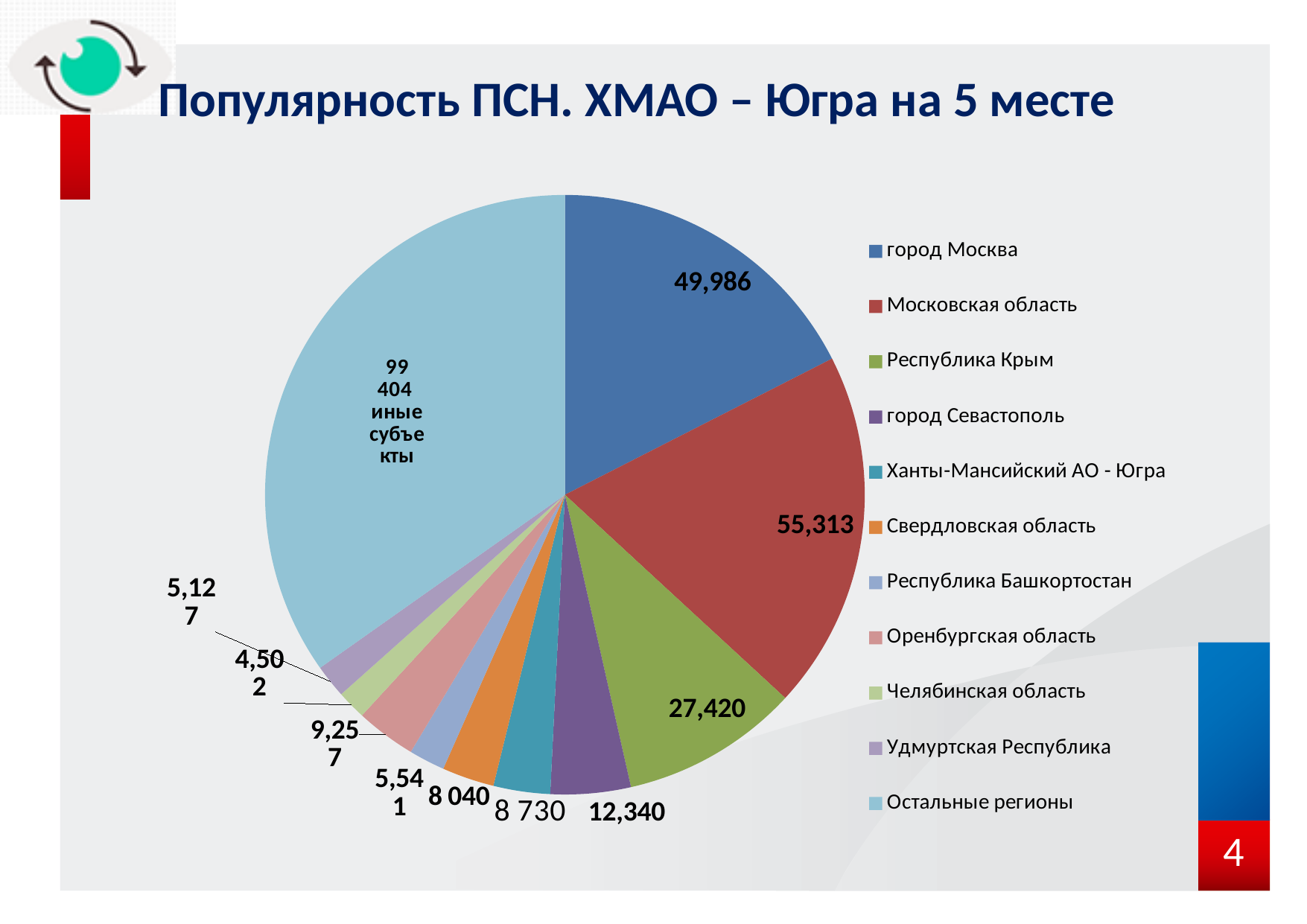
How many entries does the legend of the pie chart list? 11 What is the value shown for город Москва? 49,986 What is the value shown for Республика Крым? 27,420 What is the title of the slide? Популярность ПСН. ХМАО – Югра на 5 месте What is the value shown for город Севастополь? 12,340 What is the value shown for Московская область? 55,313 What is the difference between the values for Московская область and город Москва? 5,327 Which is larger, the value for Республика Крым or for город Севастополь? Республика Крым What kind of chart is shown on the slide? Pie chart What is the value shown for Остальные регионы (иные субъекты)? 99 404 Which legend category has the largest slice of the pie? Остальные регионы Which is larger, the value for город Москва or for Московская область? Московская область